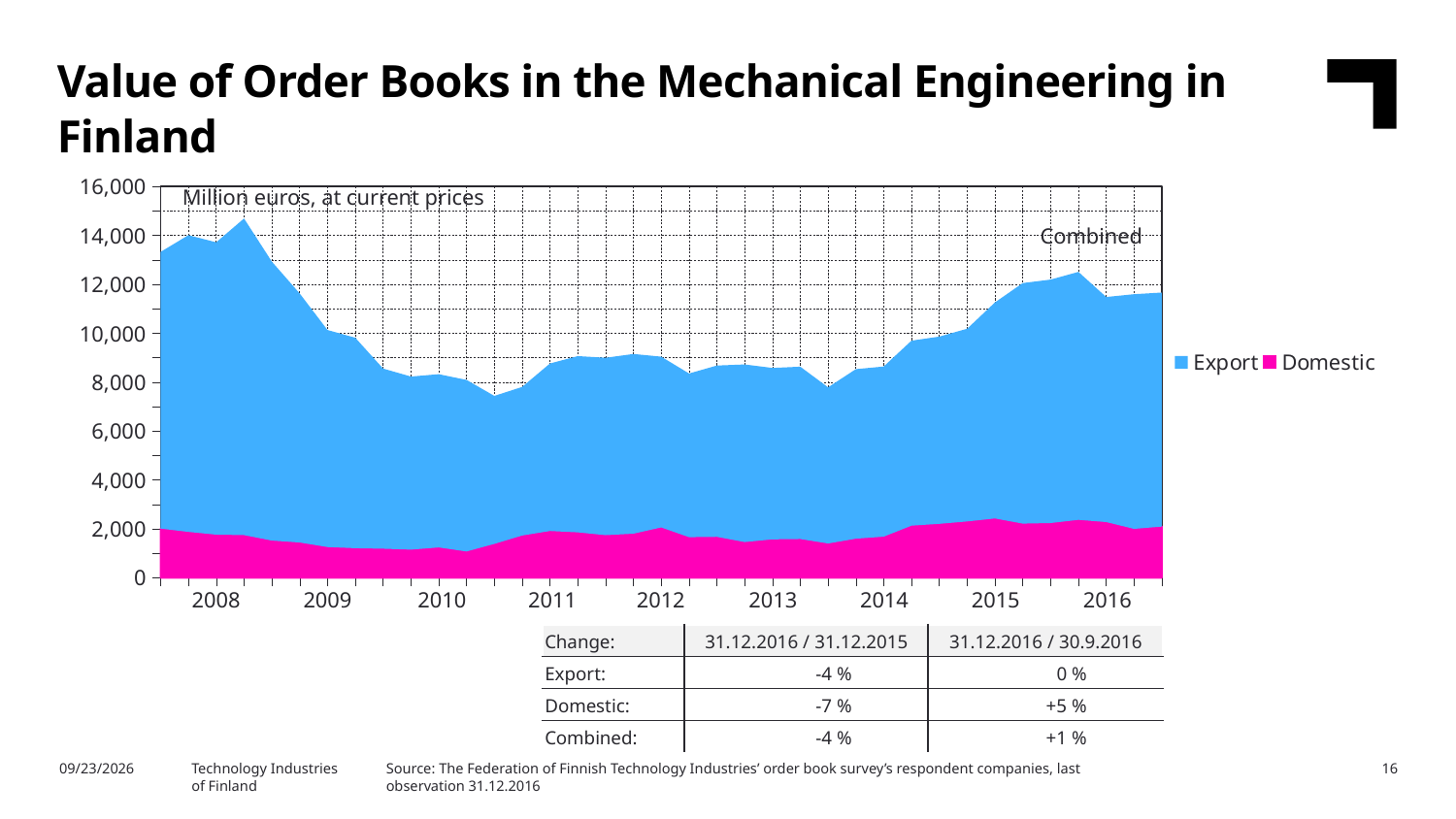
In what unit are the values on the chart expressed, according to the note inside the plot area? Million euros, at current prices Is the combined value in 2015 greater or less than 10,000? greater Is the combined value at its peak in 2008 greater or less than 14,000? greater Which year has the higher combined value, 2010 or 2015? 2015 Is the combined value at the start of 2008 greater or less than 12,000? greater Which two series are listed in the chart's legend? Export and Domestic How many years are labelled on the x axis of the chart? 9 How many series does the chart's legend list? 2 What kind of chart is shown on the slide? Stacked area chart Does the combined value rise or fall from 2008 to 2010? fall